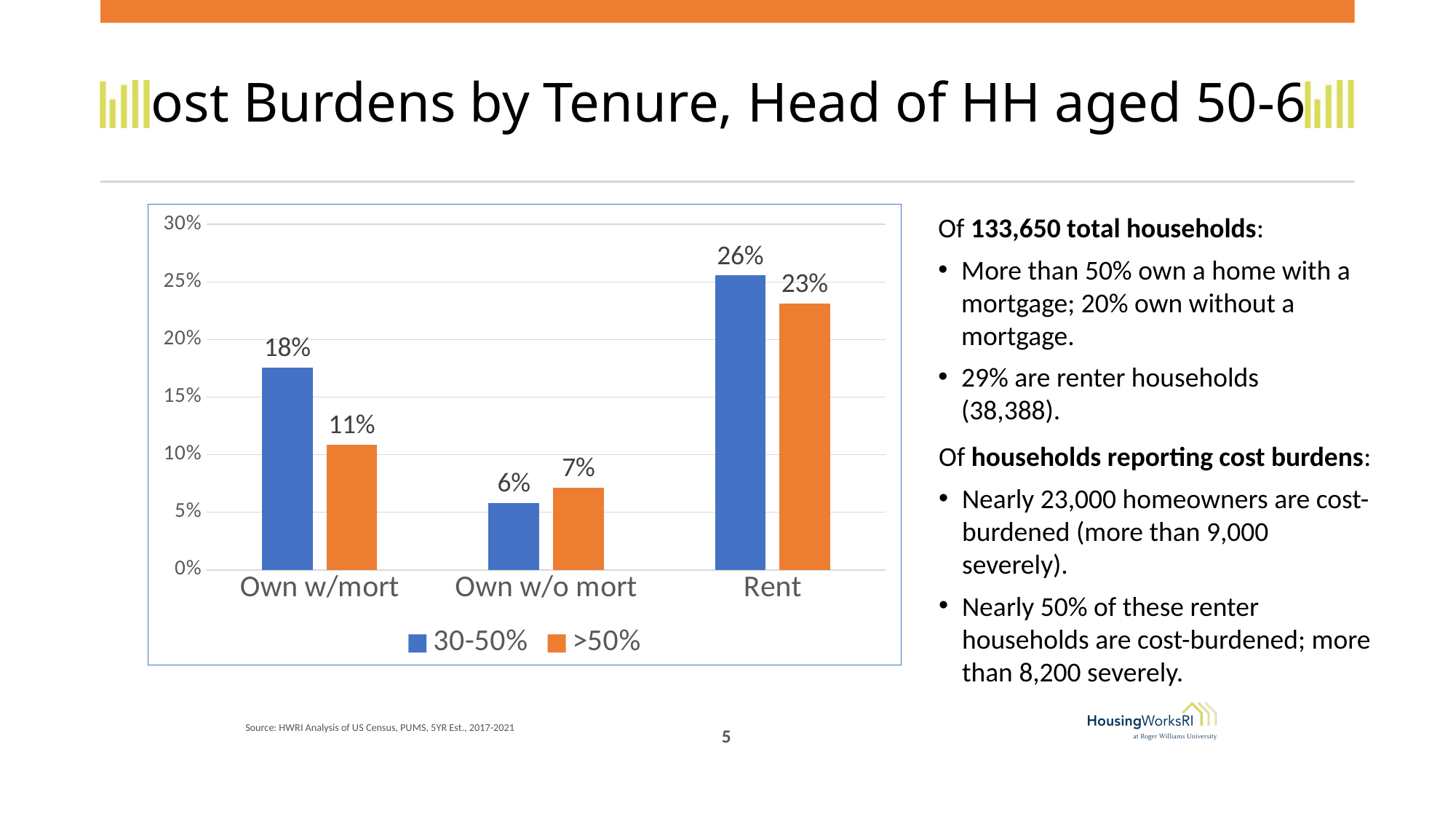
What is the value for Rent in the 30-50% series? 26% Which category has the highest value in the 30-50% series? Rent What colour are the bars for the >50% series? orange Which category has the lowest value in the >50% series? Own w/o mort How many series does the legend list? 2 What is the value for Own w/o mort in the >50% series? 7% For Own w/o mort, which series has the larger value, 30-50% or >50%? >50% What kind of chart is shown on the slide? bar chart How many categories are shown on the x axis? 3 Is the value for Rent in the >50% series greater or less than 20%? greater What is the difference between the 30-50% and >50% values for Own w/mort? 7% What is the value for Own w/mort in the >50% series? 11%